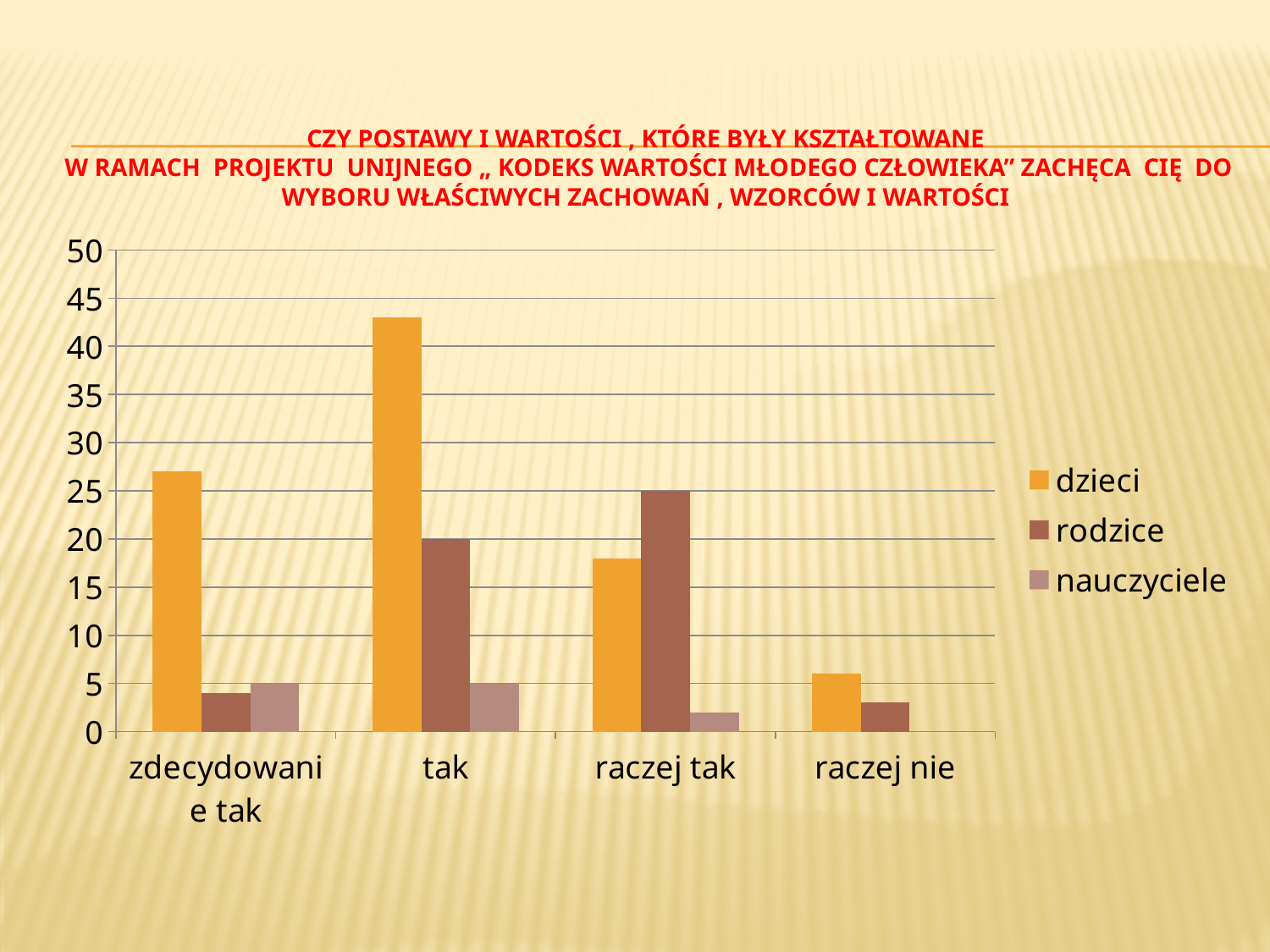
Is the value for dzieci in the 'tak' category greater or less than 40? greater Is the value for dzieci in the 'zdecydowanie tak' category greater or less than 25? greater What is the value for rodzice in the 'tak' category? 20 Which category has the highest value for rodzice? raczej tak In the 'raczej tak' category, which is larger: dzieci or rodzice? rodzice Which category has the highest value for dzieci? tak Is the value for dzieci in the 'raczej nie' category greater or less than 10? less What is the value for rodzice in the 'raczej tak' category? 25 How many series does the legend list? 3 What kind of chart is shown on the slide? bar chart What is the value for nauczyciele in the 'tak' category? 5 How many categories are shown on the x axis? 4